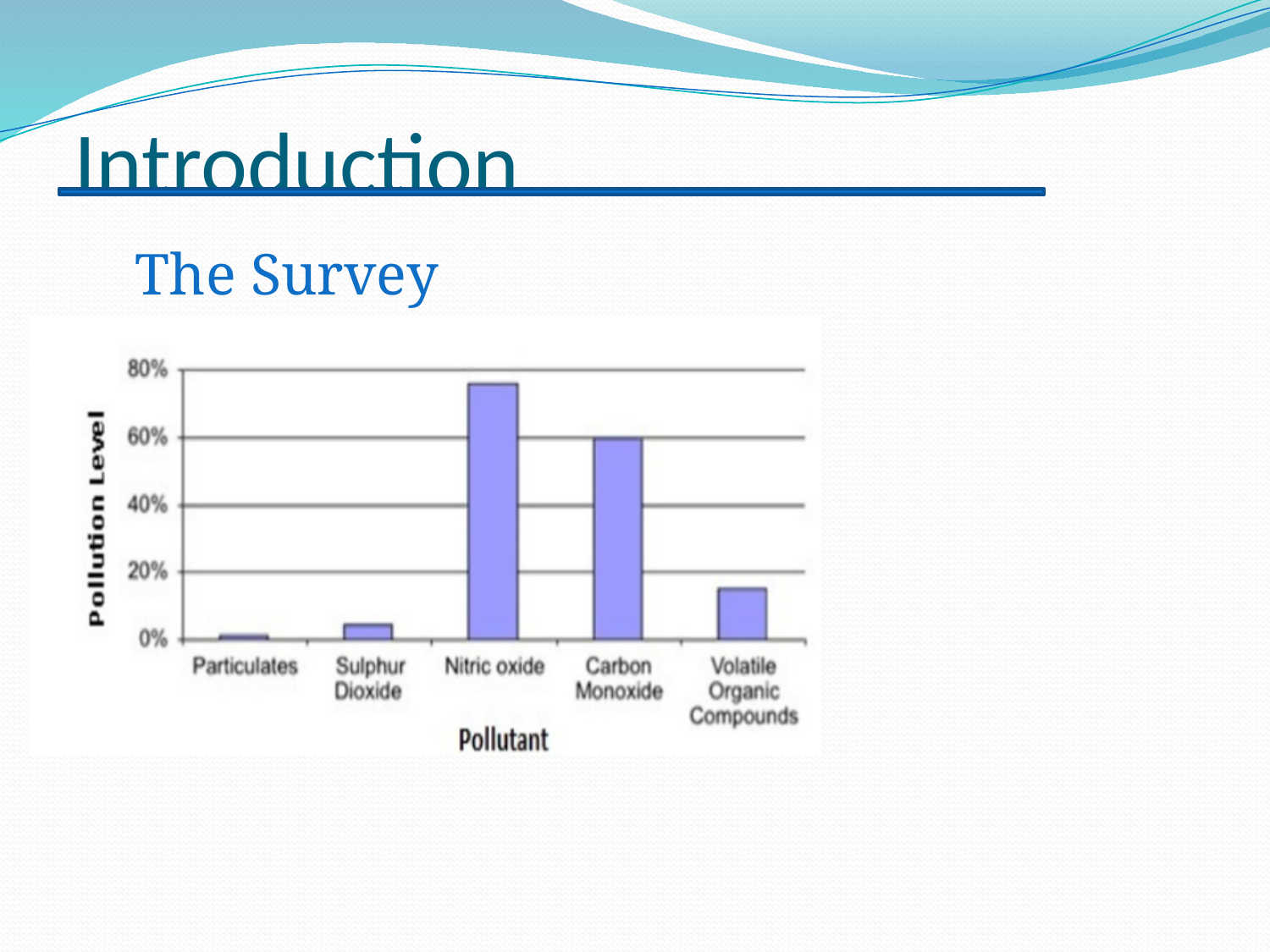
Is the pollution level for Volatile Organic Compounds greater or less than 20%? less Is the pollution level for Nitric oxide greater or less than 60%? greater What kind of chart is shown on the slide? bar chart What is the title of the x axis of the chart? Pollutant Which pollutant has the highest pollution level? Nitric oxide Which pollutant has the lowest pollution level? Particulates Is the pollution level for Sulphur Dioxide greater or less than 20%? less Which has a higher pollution level, Nitric oxide or Carbon Monoxide? Nitric oxide What is the title of the y axis of the chart? Pollution Level Which has a higher pollution level, Sulphur Dioxide or Volatile Organic Compounds? Volatile Organic Compounds How many pollutant categories are plotted on the chart? 5